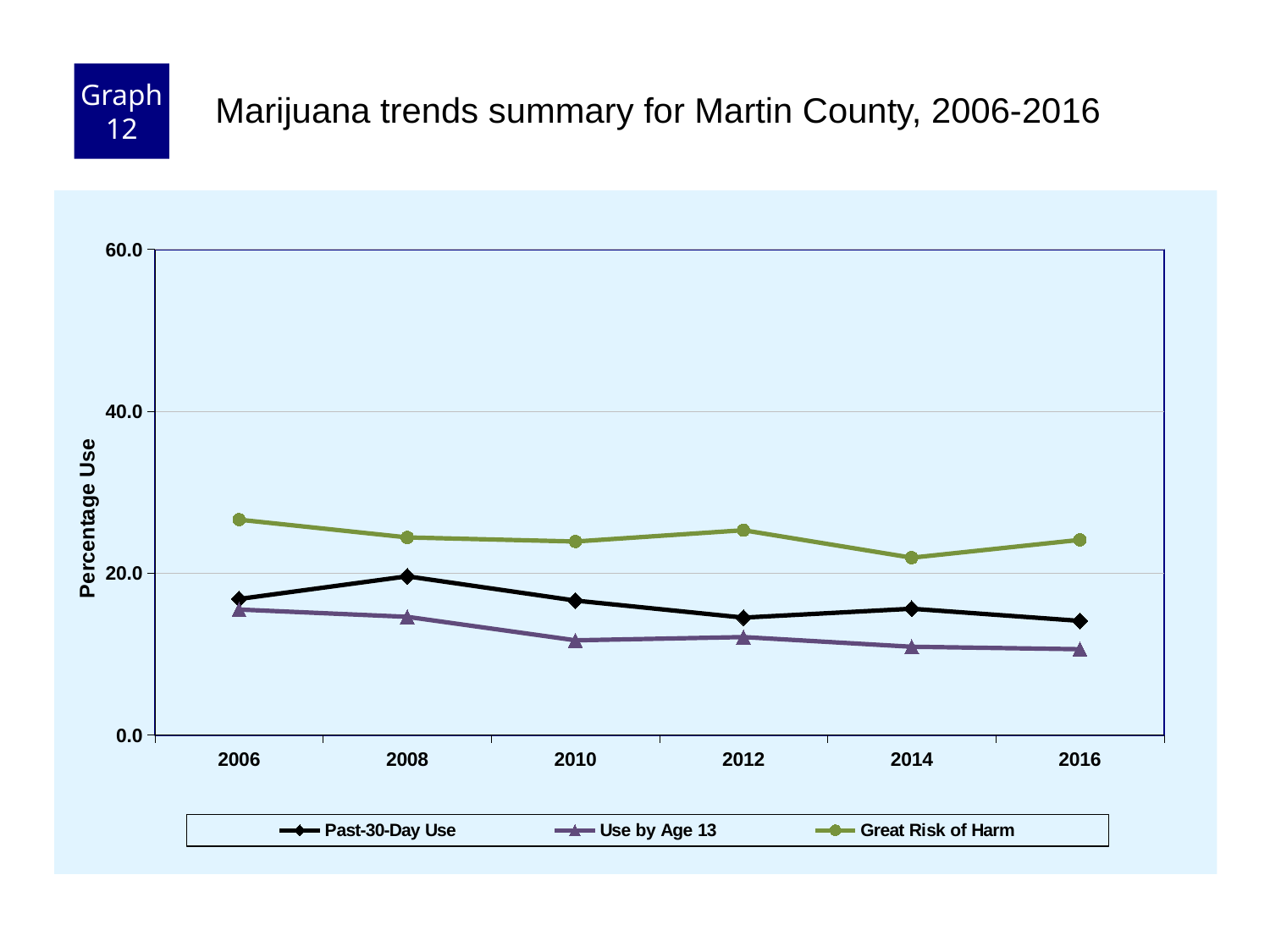
How many series does the legend list? 3 Is the value for Great Risk of Harm in 2006 greater or less than 20.0? greater In 2006, which is larger: Great Risk of Harm or Past-30-Day Use? Great Risk of Harm In which year is Past-30-Day Use highest? 2008 In which year is Use by Age 13 highest? 2006 What is the label on the y axis? Percentage Use Is the value for Great Risk of Harm in 2012 greater or less than 40.0? less Does Use by Age 13 generally rise or fall from 2006 to 2016? fall What kind of chart is shown on the slide? line chart How many years are plotted along the x axis? 6 In which year is Great Risk of Harm lowest? 2014 Is the value for Past-30-Day Use in 2016 greater or less than 20.0? less